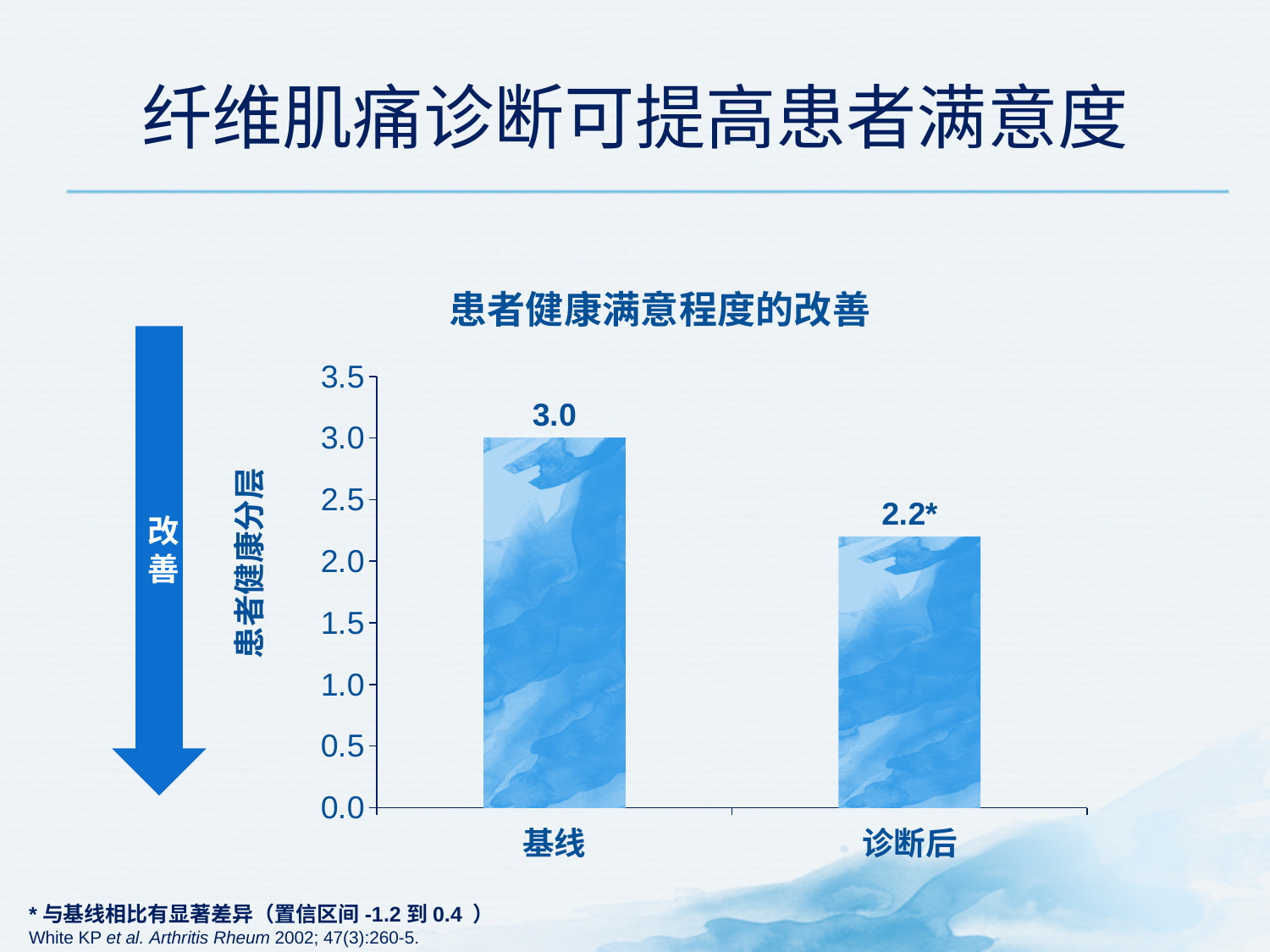
What is the value for 基线 in the chart? 3.0 What is the value for 诊断后 in the chart? 2.2 Which category has the lowest value in the chart? 诊断后 What is the title of the chart? 患者健康满意程度的改善 How many categories are shown on the x axis of the chart? 2 What kind of chart is shown on the slide? bar chart What is the difference between the values for 基线 and 诊断后? 0.8 Which is larger, the value for 基线 or the value for 诊断后? 基线 Is the value for 基线 greater or less than 2.5? greater Do the values rise or fall from 基线 to 诊断后? fall Which category has the highest value in the chart? 基线 Is the value for 诊断后 greater or less than 2.5? less